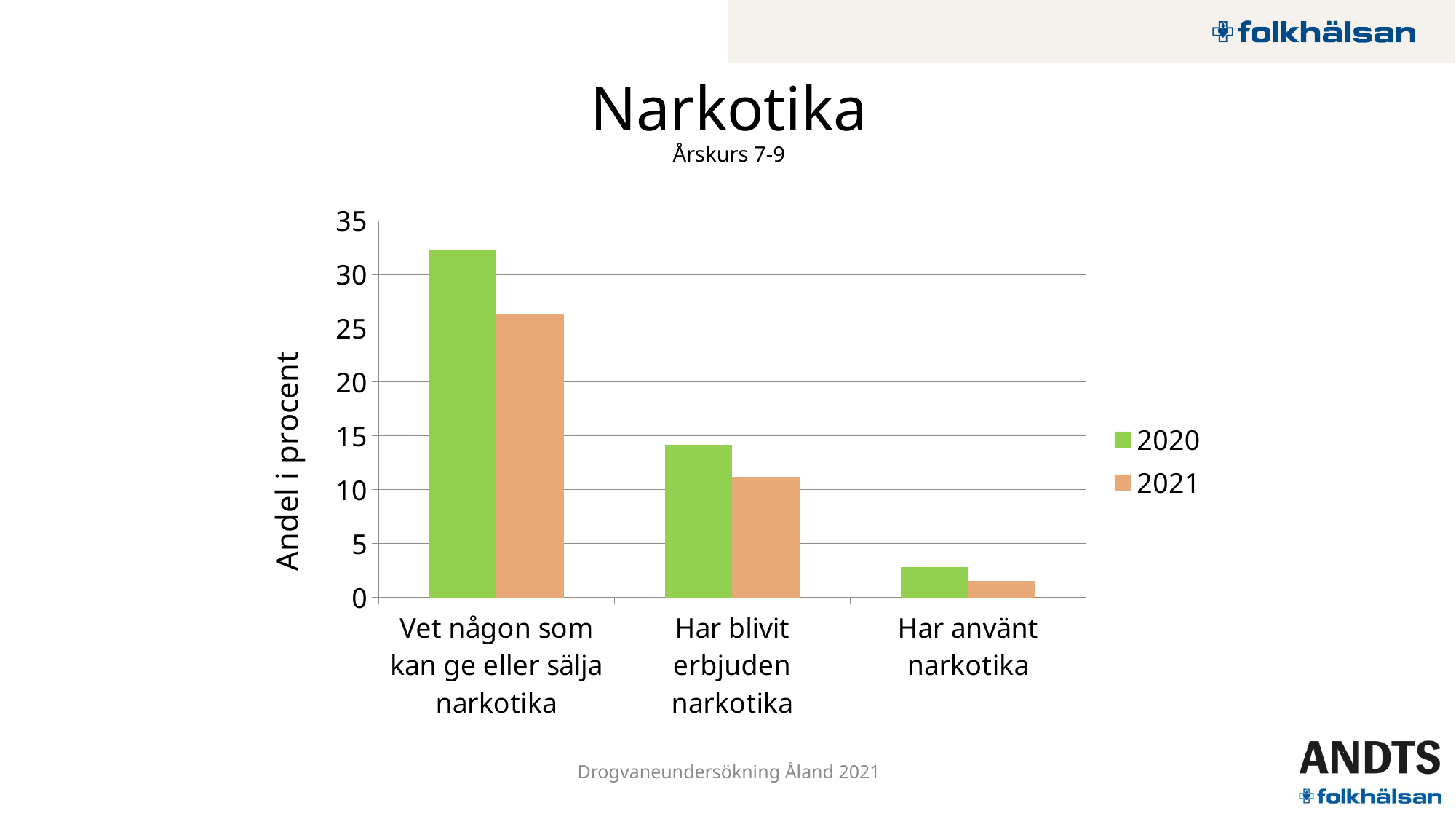
Which category has the lowest value for 2021? Har använt narkotika What kind of chart is shown on the slide? bar chart Is the 2021 value for 'Vet någon som kan ge eller sälja narkotika' greater or less than 30? less For 'Har blivit erbjuden narkotika', which year has the larger value, 2020 or 2021? 2020 Is the 2020 value for 'Vet någon som kan ge eller sälja narkotika' greater or less than 30? greater Do the 2021 values rise or fall from left to right across the categories? fall How many categories are shown on the x axis? 3 What is the label on the vertical axis? Andel i procent Which category has the highest value for 2020? Vet någon som kan ge eller sälja narkotika How many series does the legend list? 2 Is the 2020 value for 'Har blivit erbjuden narkotika' greater or less than 10? greater